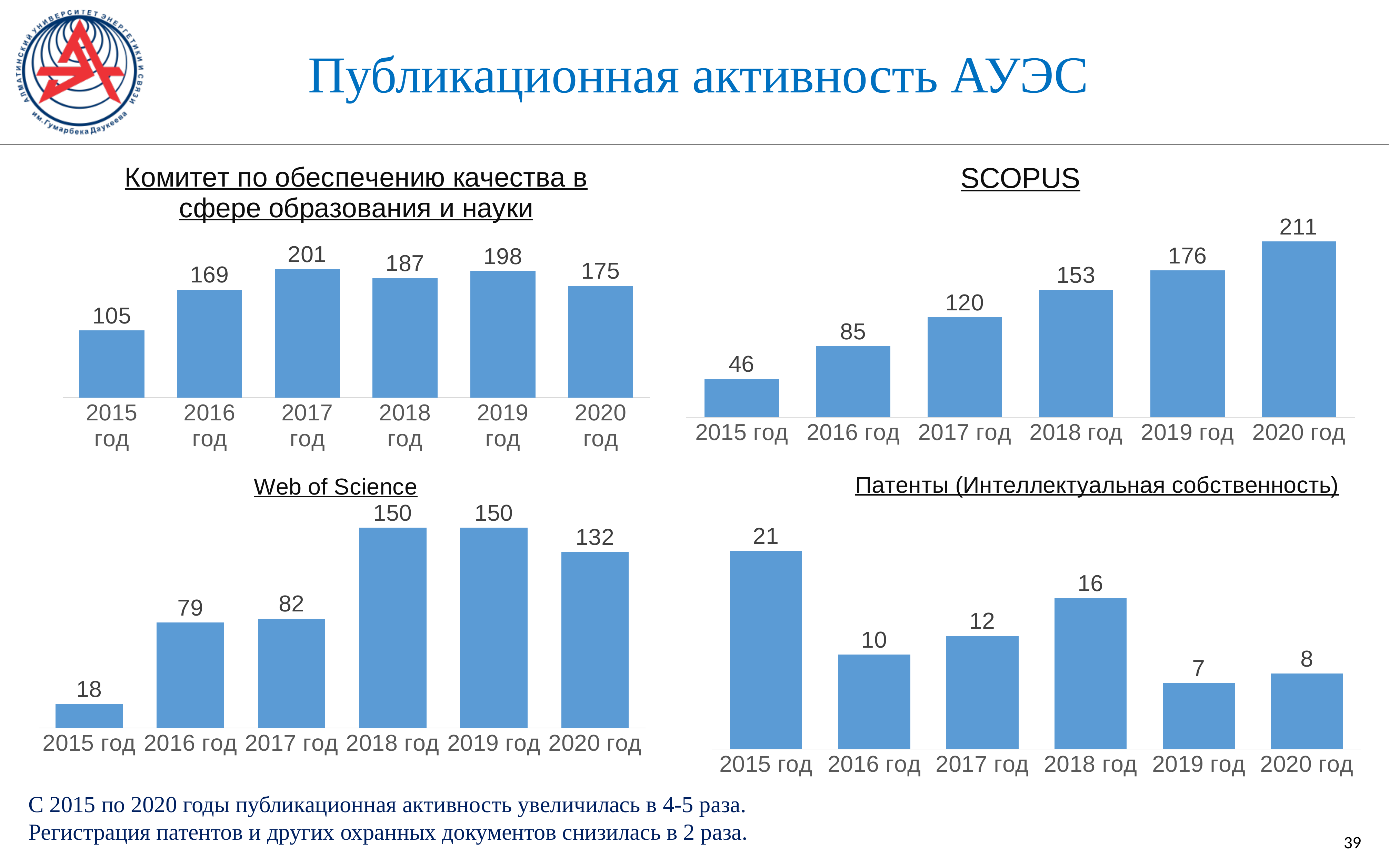
In the Web of Science chart, what is the value for 2016 год? 79 In the Патенты (Интеллектуальная собственность) chart, what is the value for 2019 год? 7 In the SCOPUS chart, what is the difference between the values for 2020 год and 2015 год? 165 What is the title of the chart in the top right of the slide? SCOPUS In the Комитет по обеспечению качества в сфере образования и науки chart, which year has the highest value? 2017 год In the SCOPUS chart, what is the value for 2018 год? 153 In the Комитет по обеспечению качества в сфере образования и науки chart, what is the difference between the values for 2019 год and 2020 год? 23 In the SCOPUS chart, do the values rise or fall from 2015 год to 2020 год? rise What kind of chart is the Web of Science chart? bar chart In the Патенты (Интеллектуальная собственность) chart, which year has the lowest value? 2019 год How many years are shown in the SCOPUS chart? 6 In the Web of Science chart, which is larger, the value for 2017 год or the value for 2020 год? 2020 год